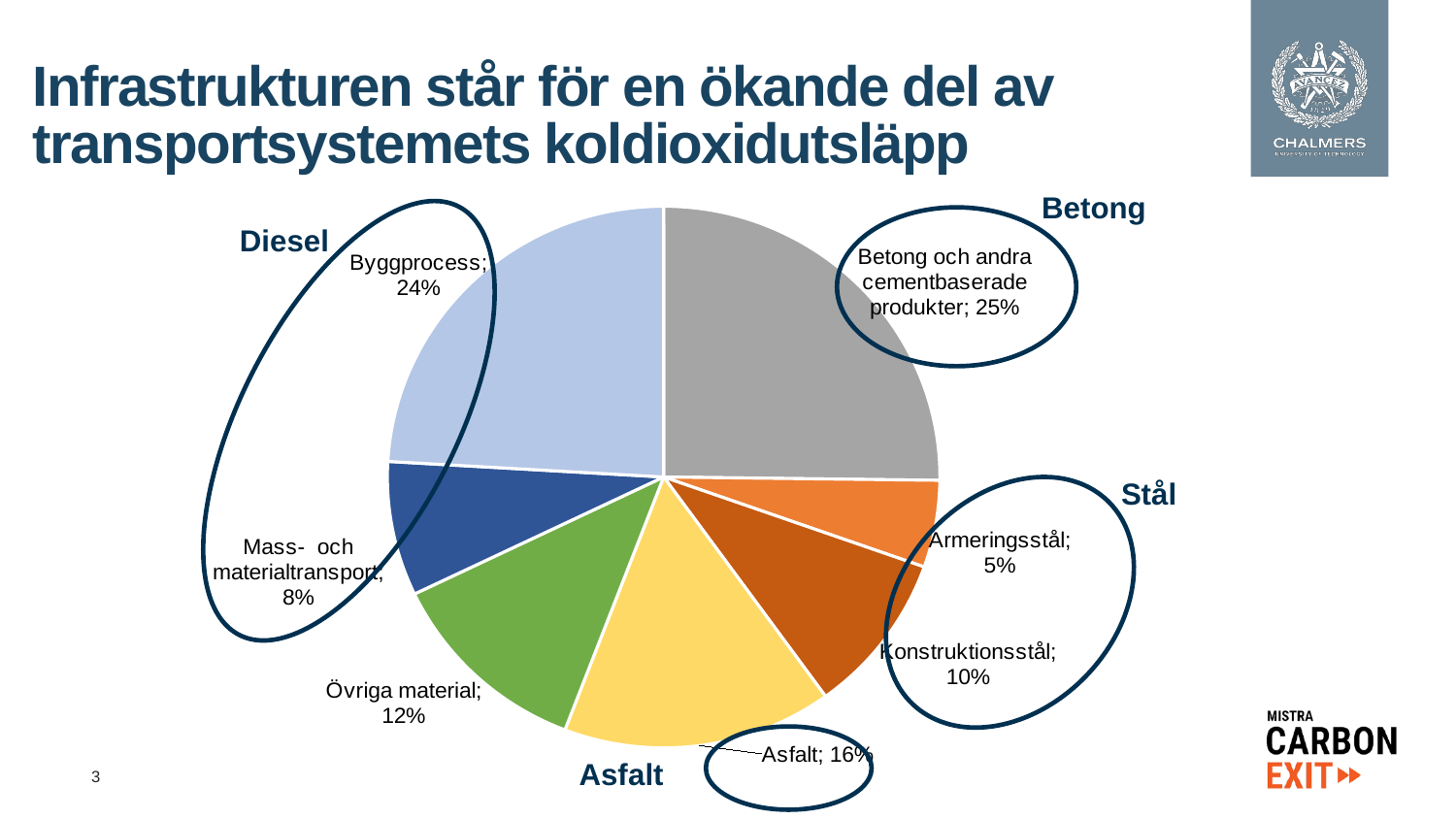
What kind of chart is shown on the slide? pie chart What is the difference in percentage points between "Övriga material" and "Armeringsstål"? 7 What share does "Betong och andra cementbaserade produkter" have in the pie chart? 25% What share does "Mass- och materialtransport" have in the pie chart? 8% What is the combined share of "Armeringsstål" and "Konstruktionsstål" (the Stål group)? 15% Which is larger, the share for "Asfalt" or the share for "Övriga material"? Asfalt Which slice of the pie chart is the smallest? Armeringsstål What share does "Byggprocess" have in the pie chart? 24% What share does "Asfalt" have in the pie chart? 16% How many slices does the pie chart have? 7 What share does "Konstruktionsstål" have in the pie chart? 10% Which slice of the pie chart is the largest? Betong och andra cementbaserade produkter